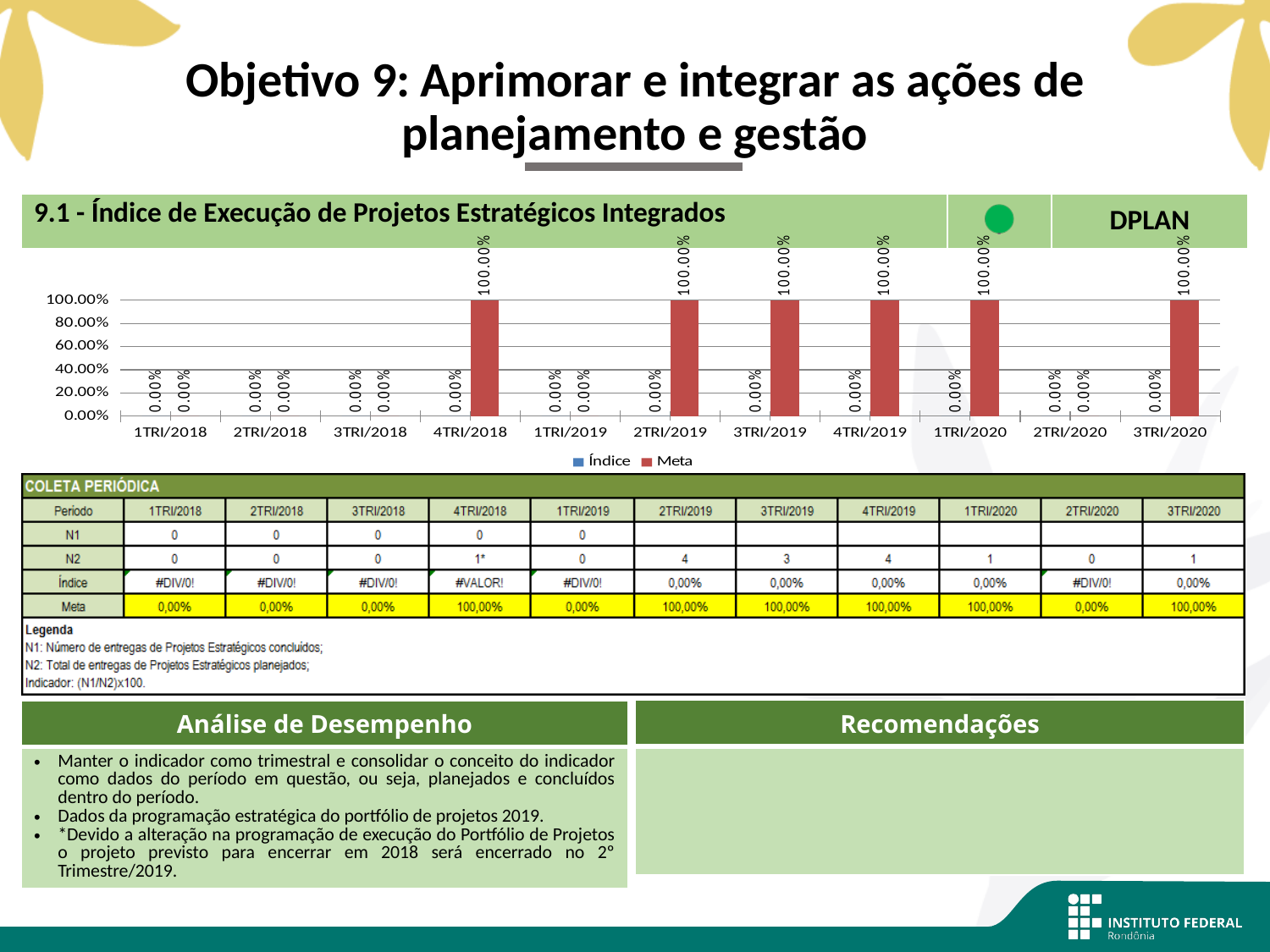
Which is larger for 3TRI/2020, the Meta value or the Índice value? Meta What kind of chart is shown on the slide? bar chart How many series does the chart legend list? 2 What is the difference between the Meta and Índice values for 1TRI/2020? 100.00% What is the Índice value for 3TRI/2019 in the chart? 0.00% Which series in the chart is shown in red? Meta What is the Meta value for 4TRI/2018 in the chart? 100.00% Is the Meta value for 2TRI/2019 greater or less than 80.00%? greater What is the Meta value for 2TRI/2020 in the chart? 0.00% What is the Meta value for 1TRI/2019 in the chart? 0.00% How many periods are shown on the x axis of the chart? 11